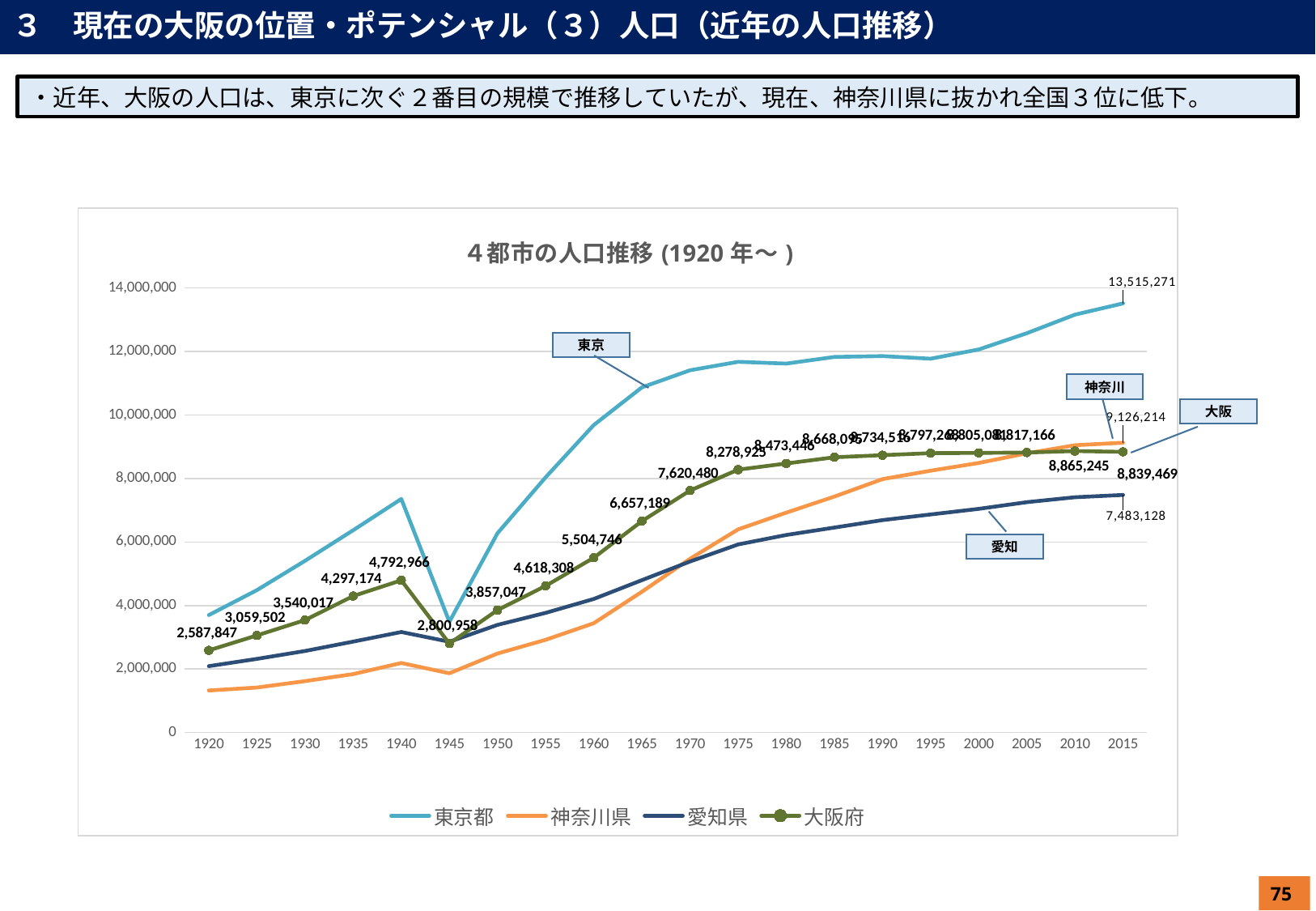
What is the population of 大阪府 in 1920 according to the chart? 2,587,847 What is the population of 大阪府 in 1945? 2,800,958 Which prefecture has the lowest population in 2015? 愛知県 What is the population of 愛知県 in 2015? 7,483,128 Which prefecture has the highest population in 2015? 東京都 How many series does the legend list? 4 Is the population of 東京都 in 1940 greater or less than 6,000,000? greater What is the difference between the 2015 populations of 神奈川県 and 大阪府? 286,745 Which is larger, the population of 大阪府 in 1940 or in 1945? 1940 What is the population of 大阪府 in 1940? 4,792,966 What is the population of 東京都 in 2015? 13,515,271 What is the population of 神奈川県 in 2015? 9,126,214